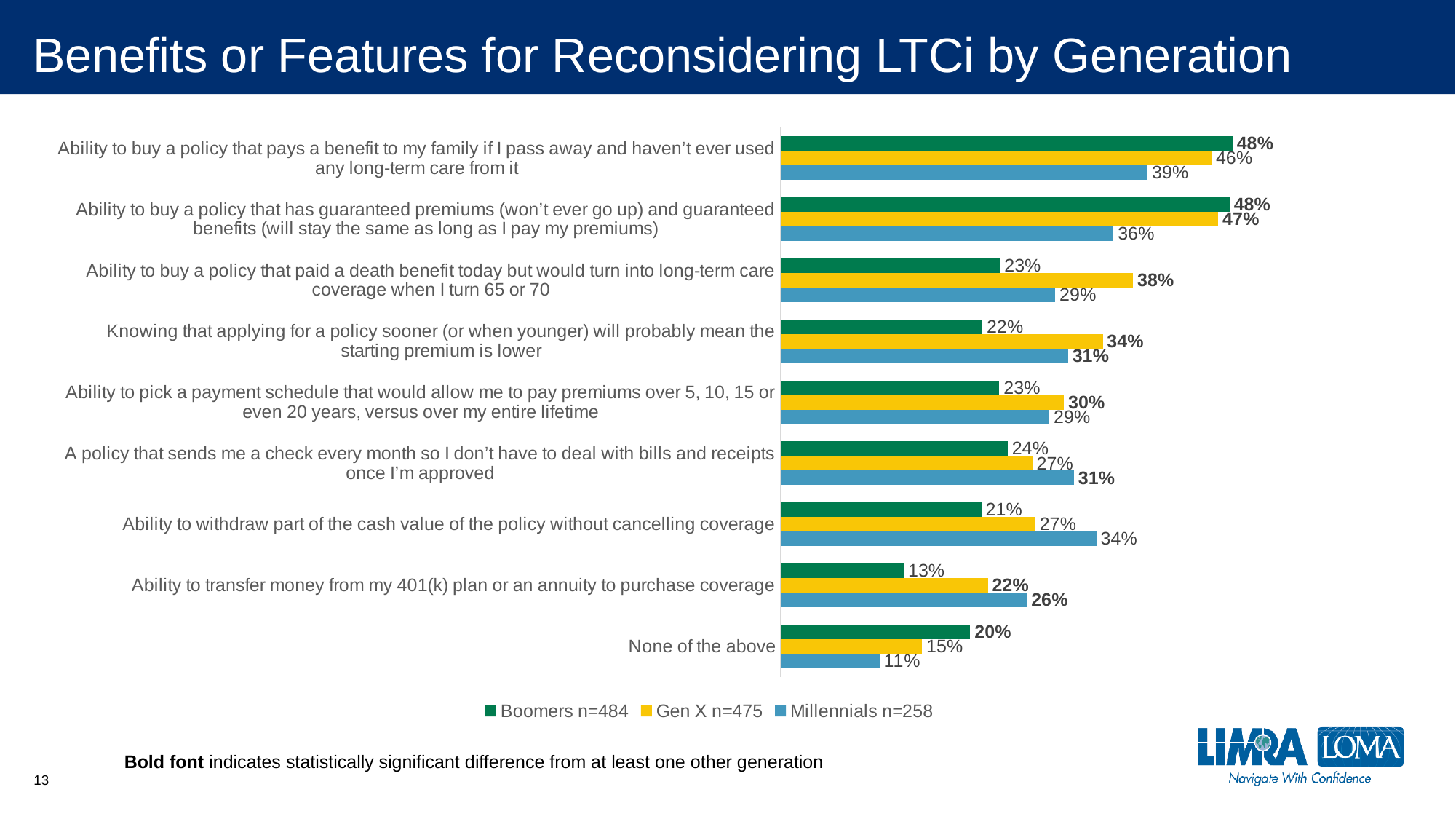
How many series does the legend list? 3 What percentage of Millennials cited "Ability to withdraw part of the cash value of the policy without cancelling coverage"? 34% What type of chart is shown on the slide? Bar chart Which category has the lowest Millennials value? None of the above What percentage of Boomers selected "None of the above"? 20% What is the sample size for Gen X shown in the legend? n=475 What is the Gen X value for "Ability to buy a policy that paid a death benefit today but would turn into long-term care coverage when I turn 65 or 70"? 38% What does bold font indicate on the chart, according to the note on the slide? Statistically significant difference from at least one other generation What is the difference between the Boomers and Millennials values for "Ability to transfer money from my 401(k) plan or an annuity to purchase coverage"? 13% Which category has the highest Gen X value? Ability to buy a policy that has guaranteed premiums (won't ever go up) and guaranteed benefits (will stay the same as long as I pay my premiums) How many benefit/feature categories are shown on the chart? 9 For "A policy that sends me a check every month so I don't have to deal with bills and receipts once I'm approved", which generation has the larger value, Boomers or Millennials? Millennials